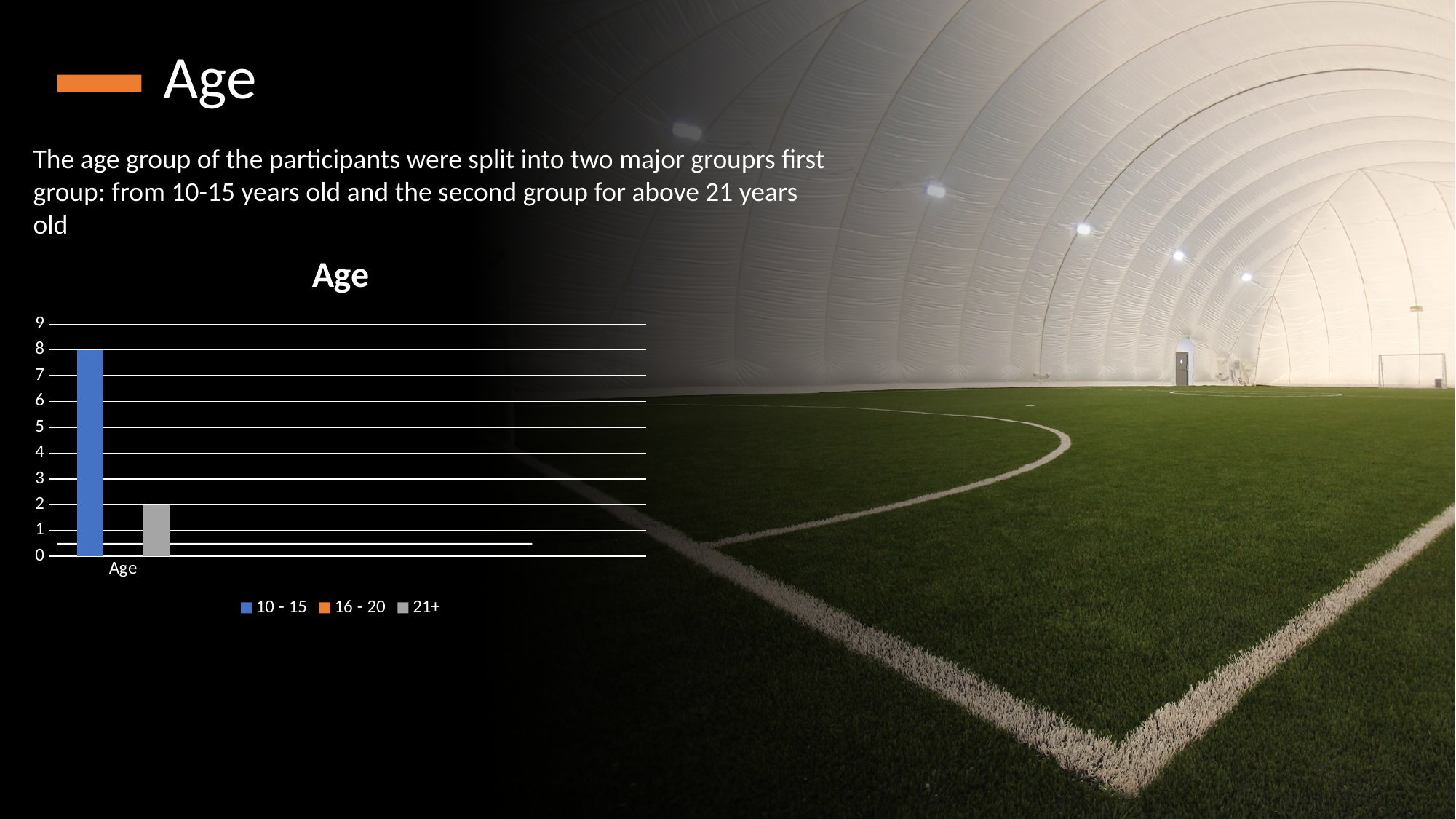
Is the value for the 21+ series greater or less than 5? less What is the value for the 21+ series? 2 Which series has the highest value? 10 - 15 What is the value for the 10 - 15 series? 8 Which of the two visible bars is larger, 10 - 15 or 21+? 10 - 15 How many series does the chart legend list? 3 How many categories are shown on the x axis? 1 What kind of chart is shown on the slide? bar chart What is the difference between the 10 - 15 value and the 21+ value? 6 What are the series names listed in the chart legend? 10 - 15, 16 - 20, 21+ Is the value for the 10 - 15 series greater or less than 5? greater What is the title of the chart? Age